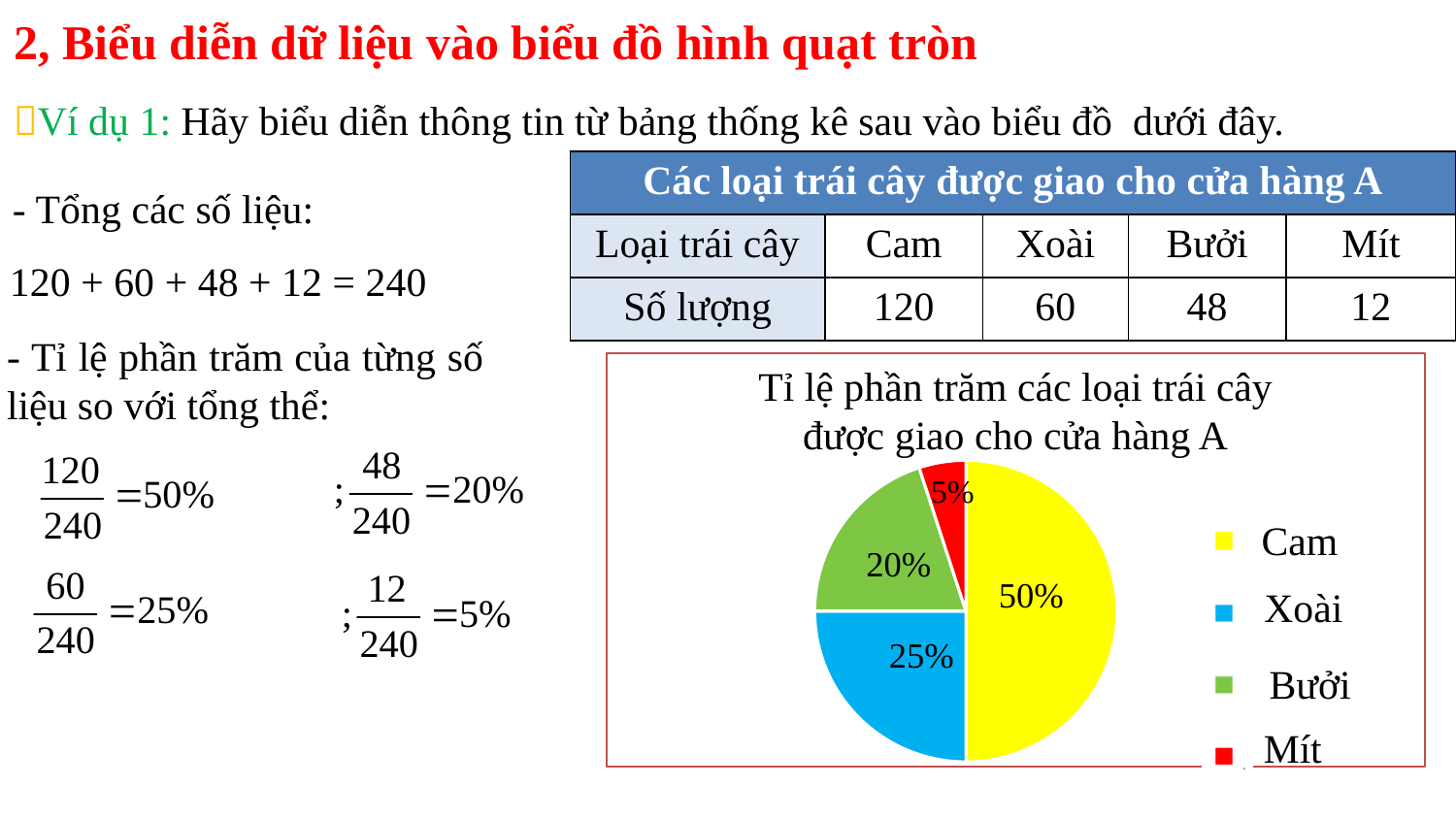
What is the share of the pie for Bưởi? 20% What is the difference in percentage points between the Cam slice and the Xoài slice? 25% What colour is the Mít slice in the pie chart? Red What is the share of the pie for Mít? 5% How many entries does the legend list? 4 How many slices does the pie chart have? 4 What kind of chart is shown on the slide? Pie chart Which slice is larger, Xoài or Bưởi? Xoài Which category has the largest slice of the pie? Cam What is the share of the pie for Cam? 50% Which category has the smallest slice of the pie? Mít